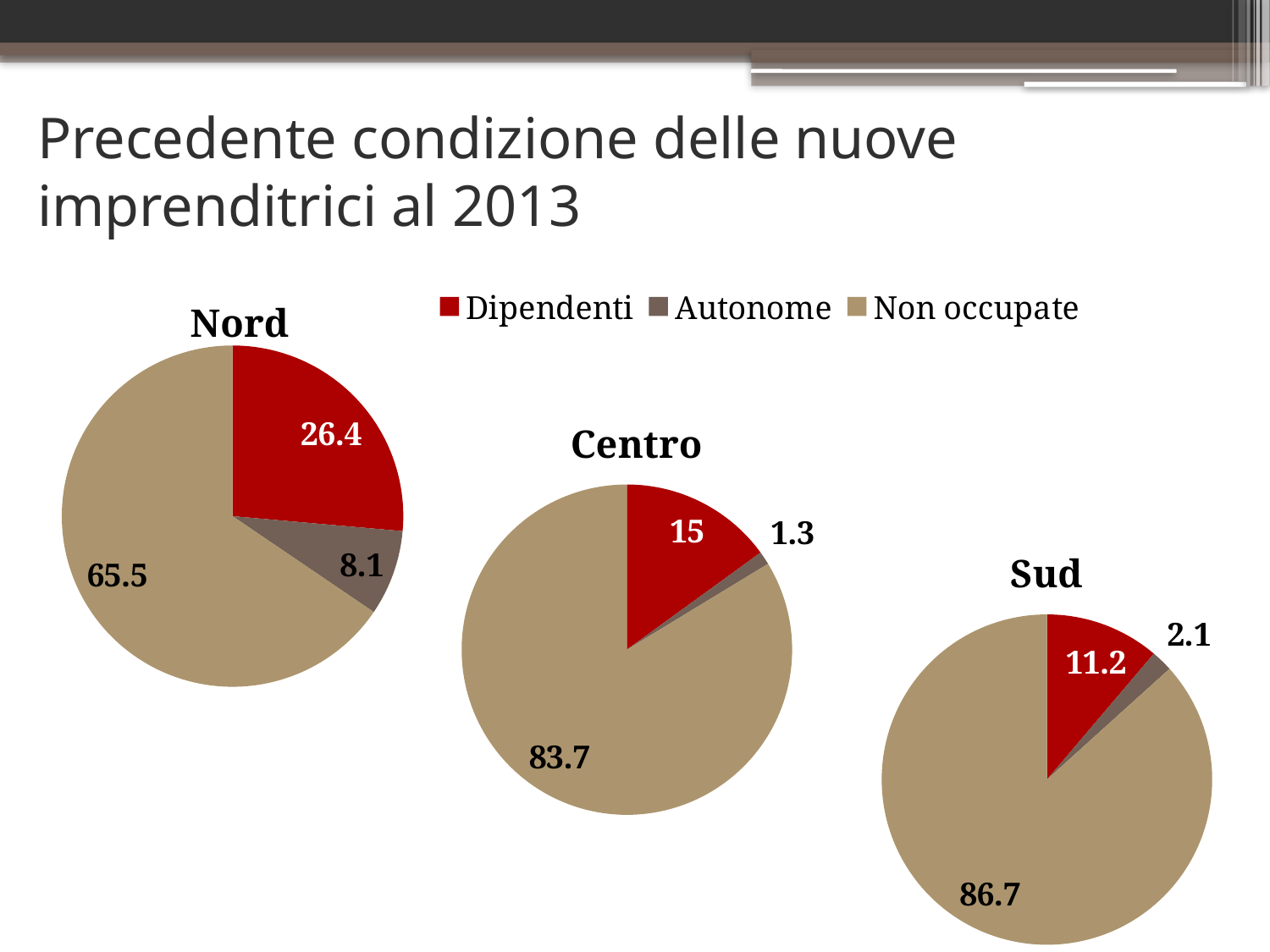
In the Centro pie chart, which category has the smallest slice? Autonome How many slices does the Centro pie chart have? 3 In the Nord pie chart, what is the value for Dipendenti? 26.4 In the Sud pie chart, what is the value for Autonome? 2.1 In the Sud pie chart, which category has the largest slice? Non occupate What kind of chart is the Sud chart? Pie chart In the Nord pie chart, what is the value for Autonome? 8.1 How many series does the legend list? 3 Which colour represents Dipendenti in the legend? Red In the Nord pie chart, what is the difference between the Non occupate value and the Dipendenti value? 39.1 In the Centro pie chart, what is the value for Non occupate? 83.7 Which is larger: the Dipendenti value in the Nord chart or the Dipendenti value in the Sud chart? Nord